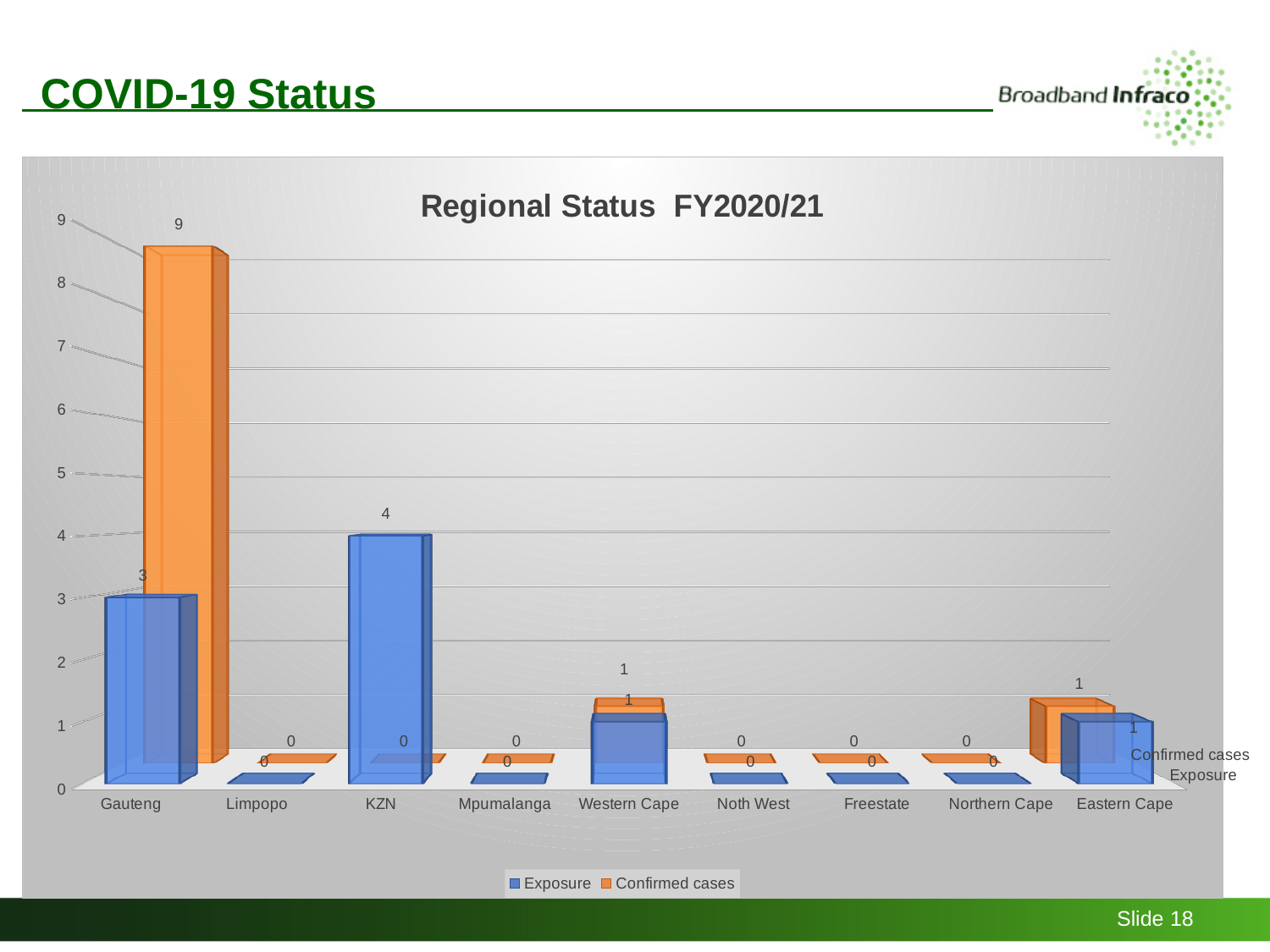
What is the Exposure value for Gauteng? 3 What is the title of the chart? Regional Status FY2020/21 What is the Exposure value for KZN? 4 What is the Confirmed cases value for Gauteng? 9 Which region has the highest Exposure value? KZN Which is larger, the Exposure value for KZN or the Exposure value for Gauteng? KZN How many series does the legend list? 2 How many regions are shown on the x axis? 9 Which region has the highest Confirmed cases value? Gauteng What is the Confirmed cases value for KZN? 0 What is the difference between Confirmed cases and Exposure for Gauteng? 6 What kind of chart is shown? Bar chart